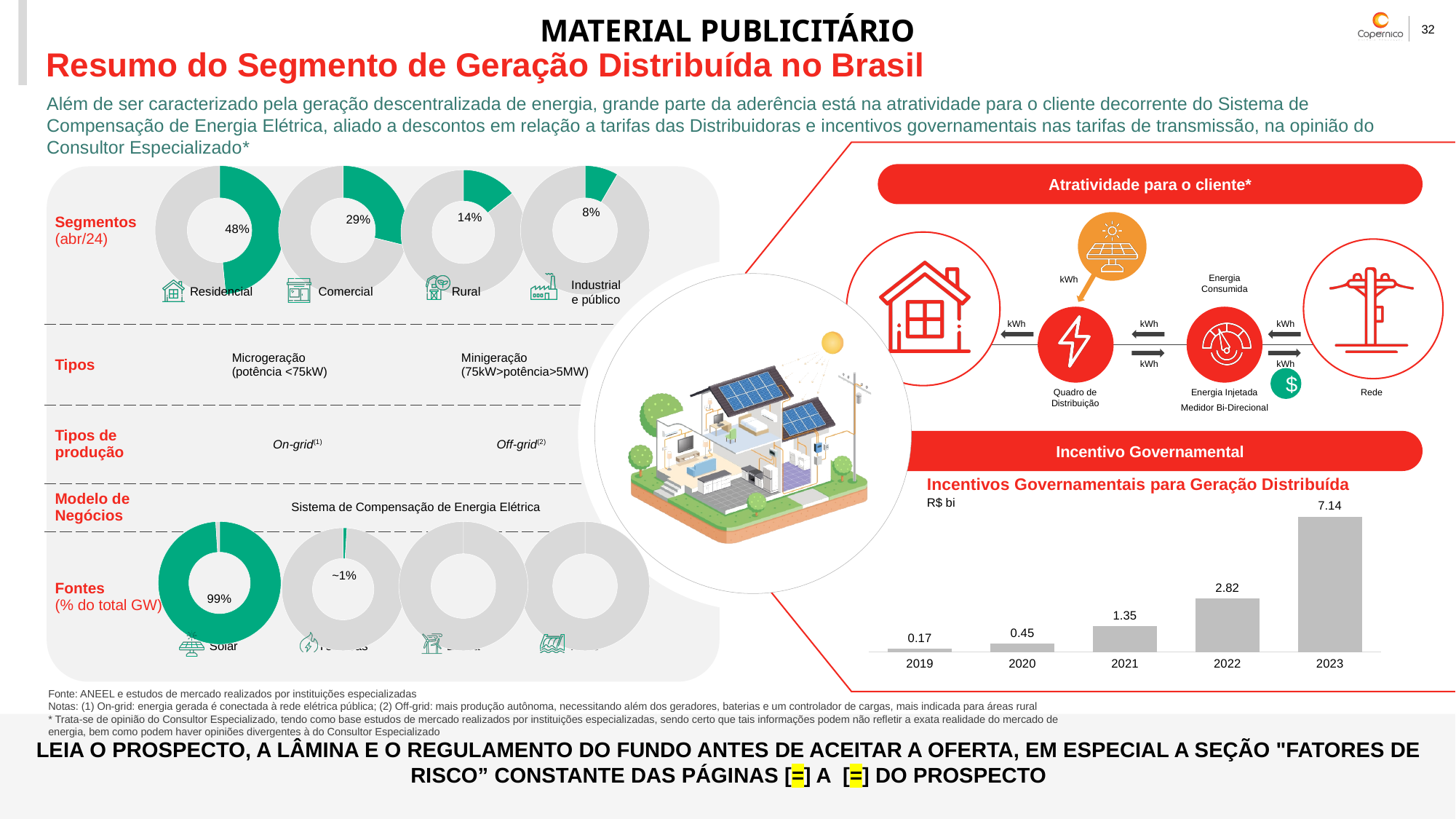
In the 'Incentivos Governamentais para Geração Distribuída' bar chart, what is the value for 2019? 0.17 In the 'Incentivos Governamentais para Geração Distribuída' bar chart, what is the value for 2021? 1.35 In the 'Incentivos Governamentais para Geração Distribuída' bar chart, do the values rise or fall from 2019 to 2023? rise In the 'Segmentos (abr/24)' donut charts, which segment has the smallest share? Industrial e público In the 'Incentivos Governamentais para Geração Distribuída' bar chart, what unit is shown for the values? R$ bi In the 'Incentivos Governamentais para Geração Distribuída' bar chart, what is the difference between the 2023 and 2022 values? 4.32 In the 'Incentivos Governamentais para Geração Distribuída' bar chart, how many years are shown? 5 In the 'Incentivos Governamentais para Geração Distribuída' bar chart, which year has the lowest value? 2019 In the 'Incentivos Governamentais para Geração Distribuída' bar chart, what is the value for 2023? 7.14 In the 'Incentivos Governamentais para Geração Distribuída' bar chart, which year has the highest value? 2023 What kind of chart is 'Incentivos Governamentais para Geração Distribuída'? bar chart In the 'Segmentos (abr/24)' donut charts, what is the share for Residencial? 48%